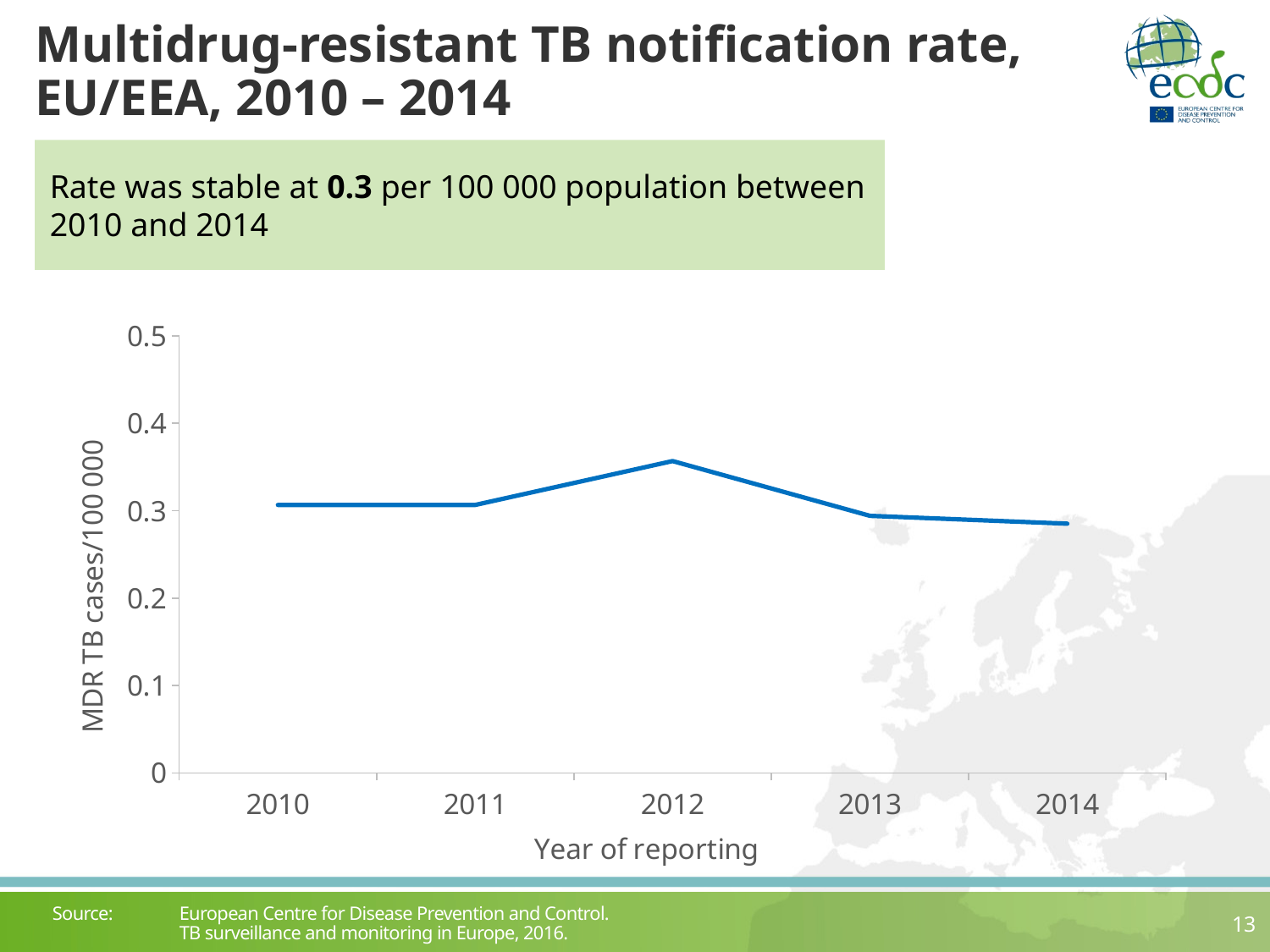
What is the label of the x axis of the chart? Year of reporting Is the value for 2012 greater or less than 0.4? less Which is larger, the value for 2010 or the value for 2012? 2012 What is the label of the y axis of the chart? MDR TB cases/100 000 Is the value for 2013 greater or less than 0.2? greater How many years are plotted on the x axis of the chart? 5 Is the value for 2014 greater or less than 0.4? less What kind of chart is shown on the slide? line chart Which is larger, the value for 2012 or the value for 2013? 2012 Which year has the highest MDR TB notification rate in the chart? 2012 Do the values rise or fall between 2012 and 2014? fall